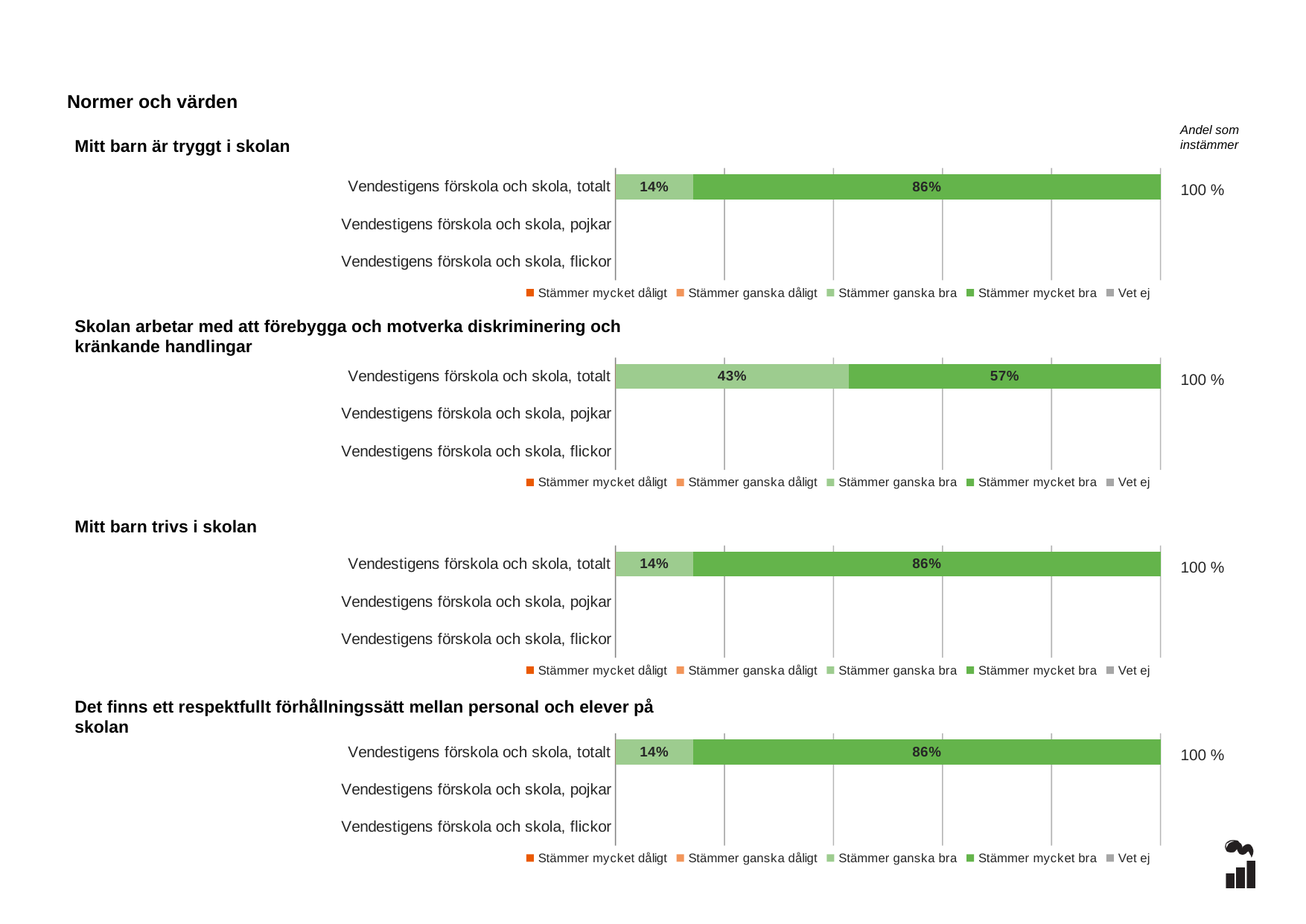
In the chart titled "Skolan arbetar med att förebygga och motverka diskriminering och kränkande handlingar", what is the difference between the "Stämmer mycket bra" and "Stämmer ganska bra" values for Vendestigens förskola och skola, totalt? 14% In the chart titled "Skolan arbetar med att förebygga och motverka diskriminering och kränkande handlingar", what is the value for "Stämmer ganska bra" for Vendestigens förskola och skola, totalt? 43% In the chart titled "Mitt barn trivs i skolan", what is the difference between the "Stämmer mycket bra" and "Stämmer ganska bra" values for Vendestigens förskola och skola, totalt? 72% What is the last legend entry in the chart titled "Mitt barn tryggt i skolan"? Vet ej What kind of chart is the chart titled "Det finns ett respektfullt förhållningssätt mellan personal och elever på skolan"? Stacked bar chart In the chart titled "Mitt barn är tryggt i skolan", what is the value for "Stämmer ganska bra" for Vendestigens förskola och skola, totalt? 14% In the chart titled "Det finns ett respektfullt förhållningssätt mellan personal och elever på skolan", what is the total of the stacked bar for Vendestigens förskola och skola, totalt? 100% In the chart titled "Mitt barn trivs i skolan", which is larger for Vendestigens förskola och skola, totalt: "Stämmer ganska bra" or "Stämmer mycket bra"? Stämmer mycket bra How many series does the legend list in the chart titled "Mitt barn tryggt i skolan"? 5 How many categories are shown on the y axis of the chart titled "Mitt barn trivs i skolan"? 3 In the chart titled "Skolan arbetar med att förebygga och motverka diskriminering och kränkande handlingar", what is the value for "Stämmer mycket bra" for Vendestigens förskola och skola, totalt? 57% In the chart titled "Mitt barn är tryggt i skolan", what is the value for "Stämmer mycket bra" for Vendestigens förskola och skola, totalt? 86%